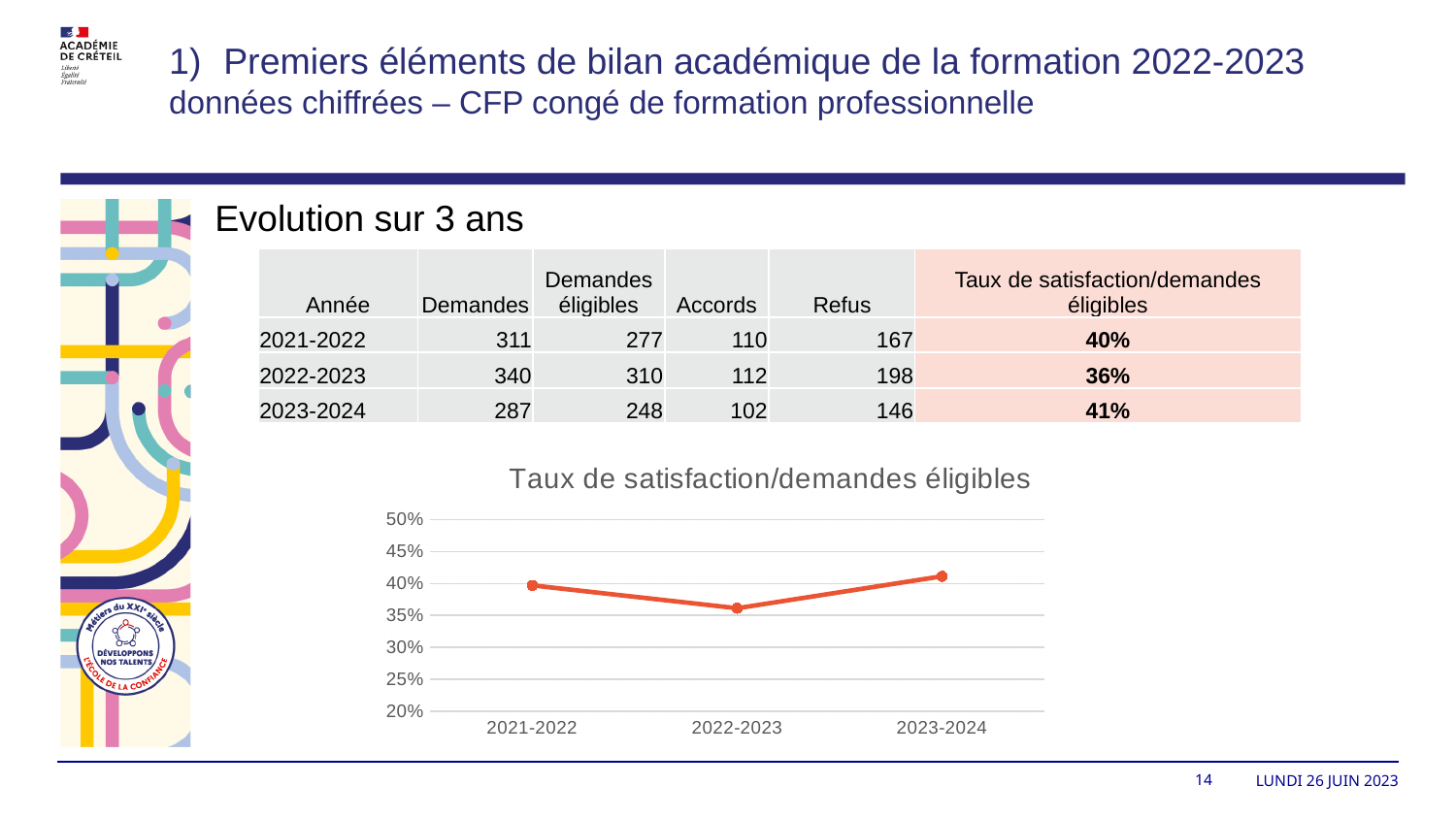
How many data points are plotted on the chart? 3 How does the value change from 2021-2022 to 2022-2023 and then to 2023-2024? falls, then rises What kind of chart is shown on the slide? line chart Which year has the highest value on the chart? 2023-2024 Is the value for 2023-2024 greater or less than 45%? less Which year has the lowest value on the chart? 2022-2023 Is the value for 2023-2024 greater or less than 40%? greater What is the title of the chart? Taux de satisfaction/demandes éligibles Which is larger, the value for 2022-2023 or the value for 2023-2024? 2023-2024 Is the value for 2022-2023 greater or less than 40%? less What is the lowest value shown on the vertical axis of the chart? 20%